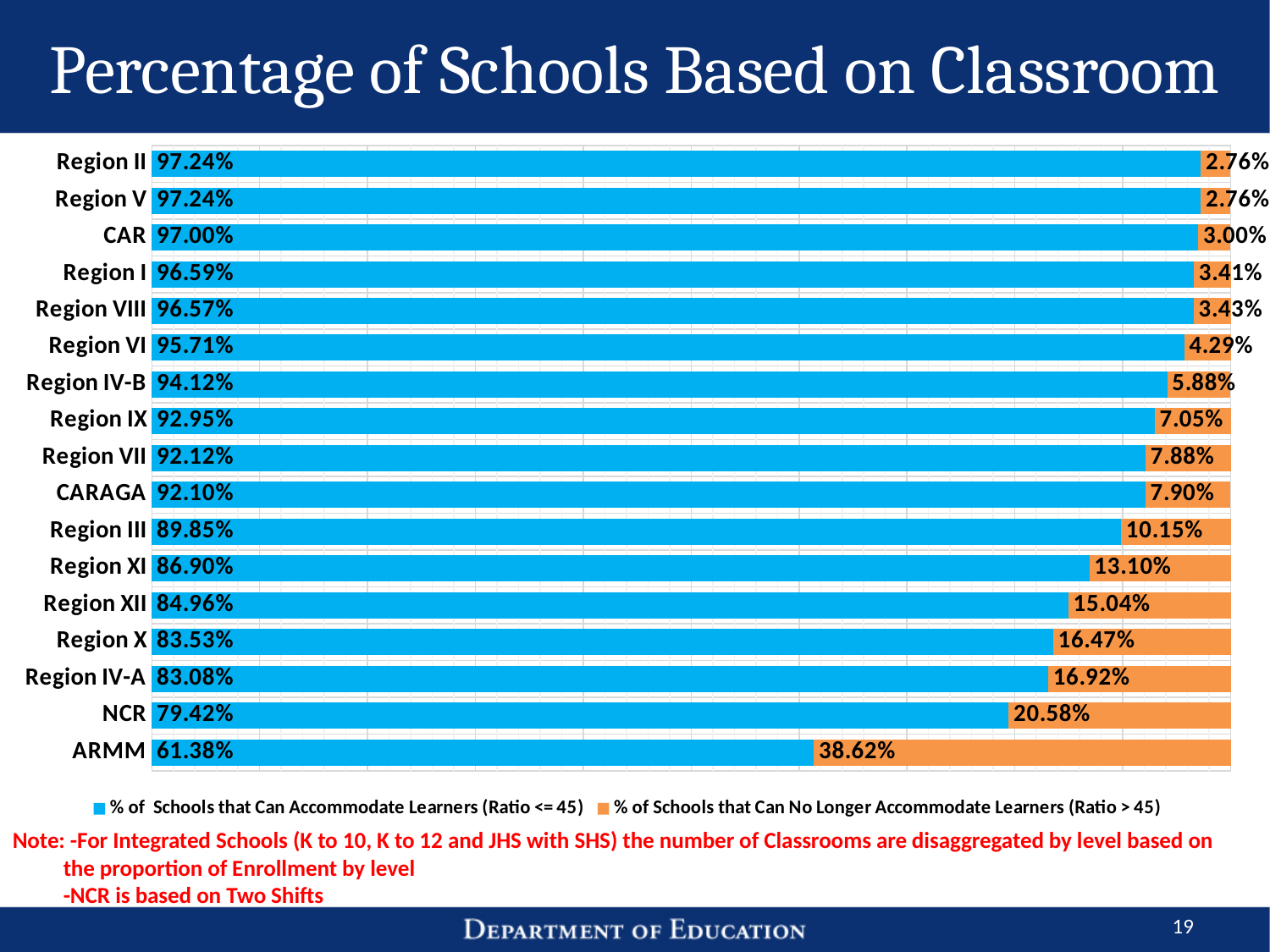
What percentage of schools in Region VI can accommodate learners (Ratio <= 45)? 95.71% What kind of chart is shown on the slide? Stacked bar chart How many regions are shown in the chart? 17 Which has a larger percentage of schools that can no longer accommodate learners, Region III or Region XI? Region XI What is the value for CARAGA in the '% of Schools that Can No Longer Accommodate Learners' series? 7.90% Which region has the highest percentage of schools that can no longer accommodate learners (Ratio > 45)? ARMM What is the difference between ARMM's and NCR's percentage of schools that can no longer accommodate learners? 18.04% What is the difference between NCR's and Region IV-A's percentage of schools that can no longer accommodate learners? 3.66% What percentage of schools in NCR can no longer accommodate learners (Ratio > 45)? 20.58% How many series does the legend list? 2 Which series is shown in blue in the chart? % of Schools that Can Accommodate Learners (Ratio <= 45) Which region has the lowest percentage of schools that can accommodate learners (Ratio <= 45)? ARMM